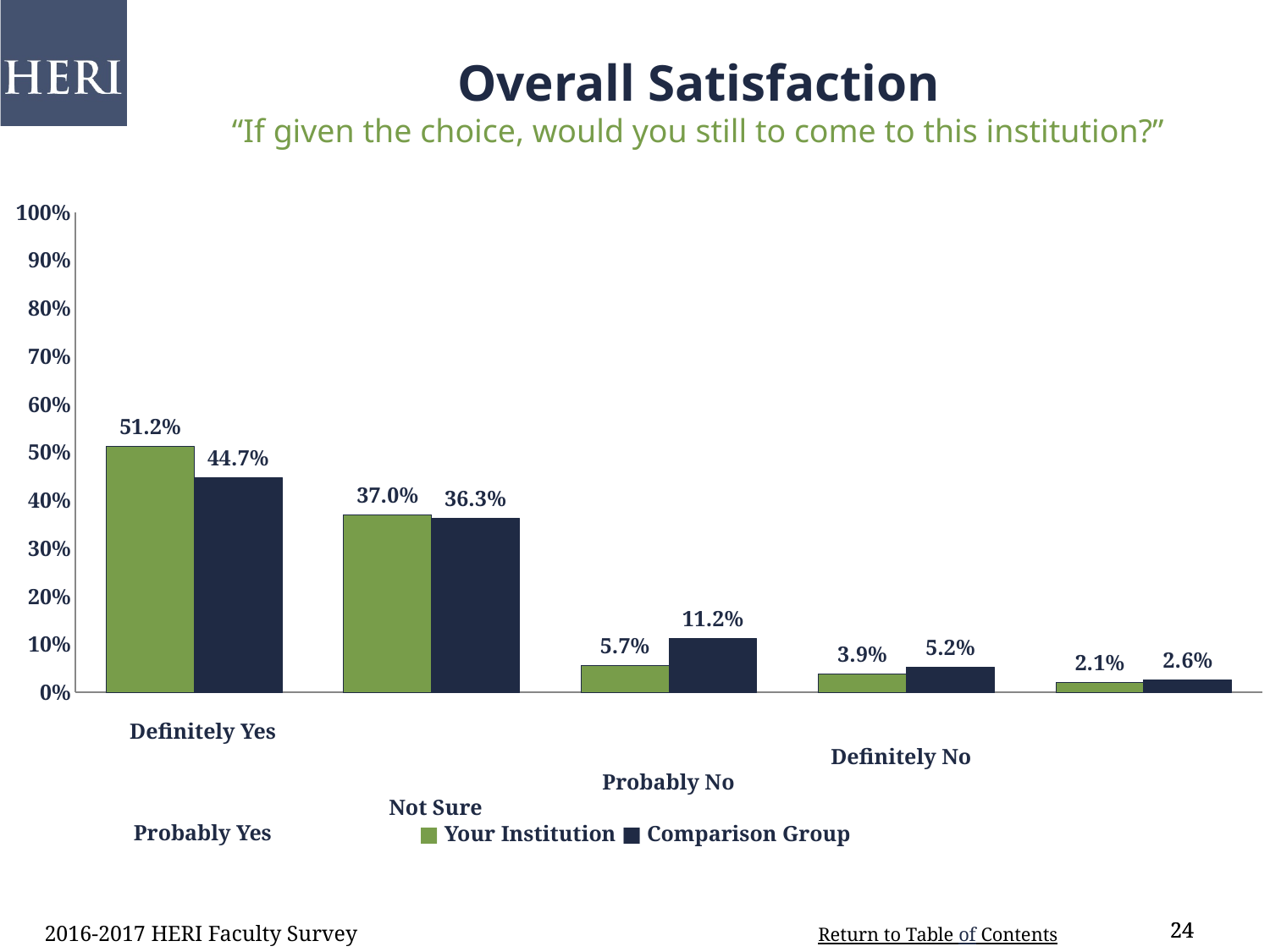
In the third group of bars from the left, which series has the larger value? Comparison Group How many series does the legend list? 2 What is the difference between the Your Institution and Comparison Group values for Definitely Yes? 6.5% Is the Your Institution value for Definitely Yes greater or less than 50%? greater What is the highest value shown for Your Institution? 51.2% What is the Your Institution value in the rightmost group of bars? 2.1% What are the two series named in the legend? Your Institution and Comparison Group What kind of chart is shown on the slide? bar chart What is the lowest value shown for the Comparison Group? 2.6% How many groups of bars are plotted in the chart? 5 What is the Your Institution value for Definitely Yes? 51.2% What is the Comparison Group value for Definitely Yes? 44.7%